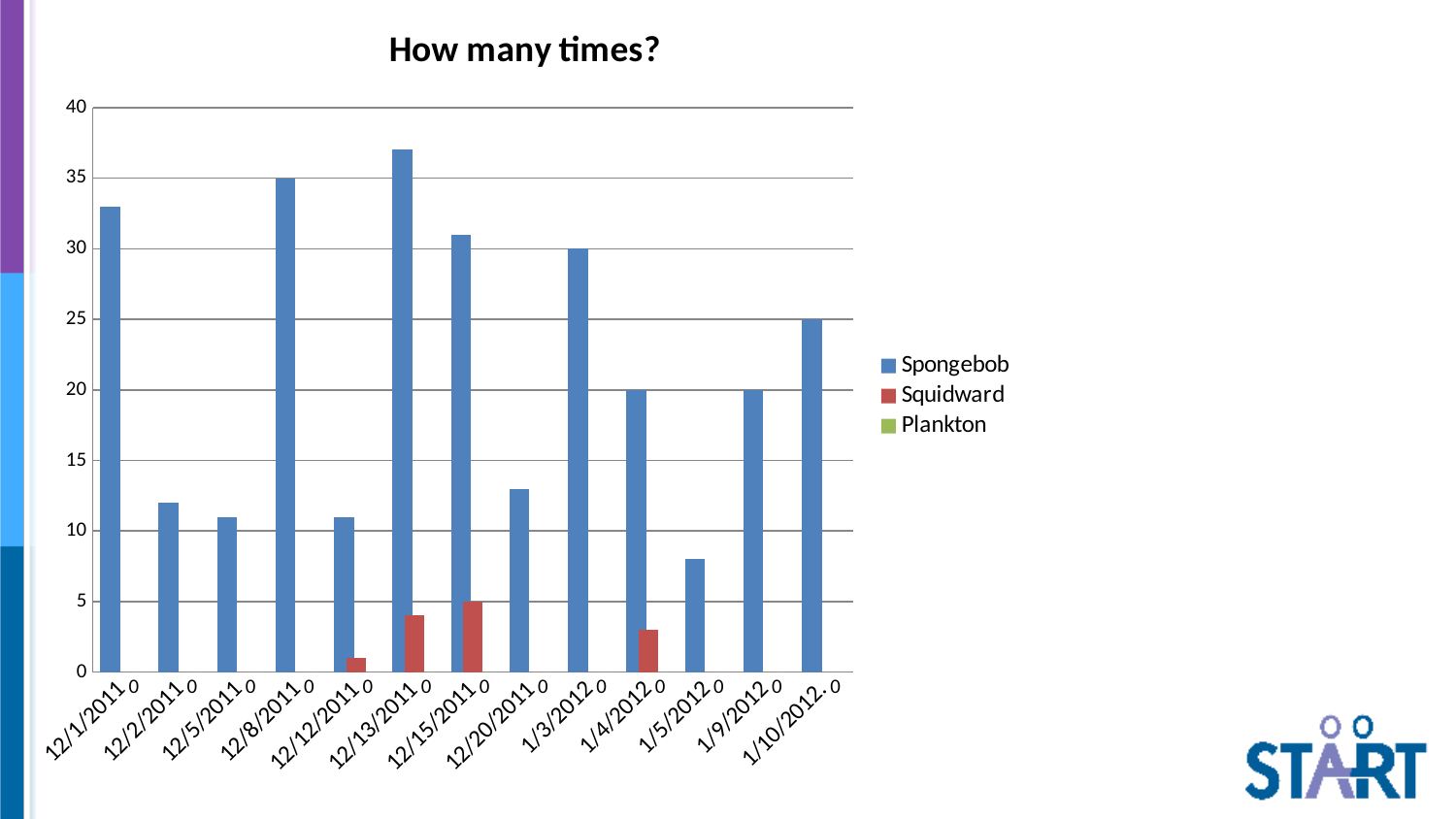
Is the Spongebob value for 12/1/2011 greater or less than 30? greater What kind of chart is shown on the slide? bar chart Which date has the highest Spongebob value? 12/13/2011 Which date has the lowest Spongebob value? 1/5/2012 How many series does the legend list? 3 What is the Spongebob value for 1/10/2012? 25 What is the Squidward value for 12/15/2011? 5 What is the title of the chart? How many times? What is the Spongebob value for 1/3/2012? 30 How many dates are shown along the x axis? 13 Is the Spongebob value for 1/5/2012 greater or less than 10? less Which is larger, the Spongebob value for 12/2/2011 or for 12/20/2011? 12/20/2011